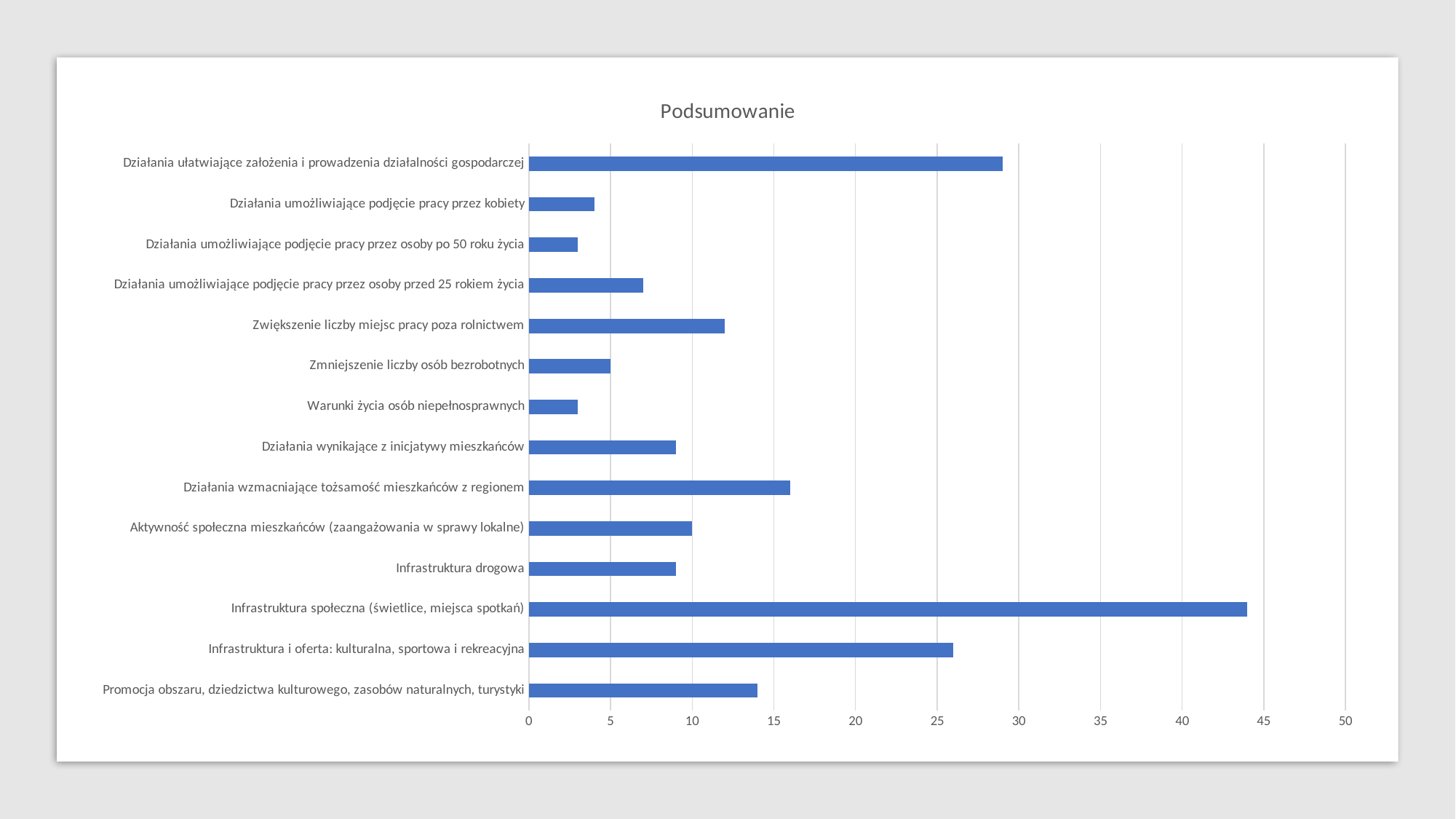
Is the value for 'Infrastruktura i oferta: kulturalna, sportowa i rekreacyjna' greater or less than 20? greater How many categories are plotted in the chart? 14 Is the value for 'Infrastruktura społeczna (świetlice, miejsca spotkań)' greater or less than 40? greater Is the value for 'Zwiększenie liczby miejsc pracy poza rolnictwem' greater or less than 10? greater Which is larger: the value for 'Zwiększenie liczby miejsc pracy poza rolnictwem' or for 'Zmniejszenie liczby osób bezrobotnych'? Zwiększenie liczby miejsc pracy poza rolnictwem Which is larger: the value for 'Infrastruktura społeczna (świetlice, miejsca spotkań)' or for 'Infrastruktura drogowa'? Infrastruktura społeczna (świetlice, miejsca spotkań) Which category has the highest value? Infrastruktura społeczna (świetlice, miejsca spotkań) What type of chart is shown on the slide? bar chart What is the title of the chart? Podsumowanie